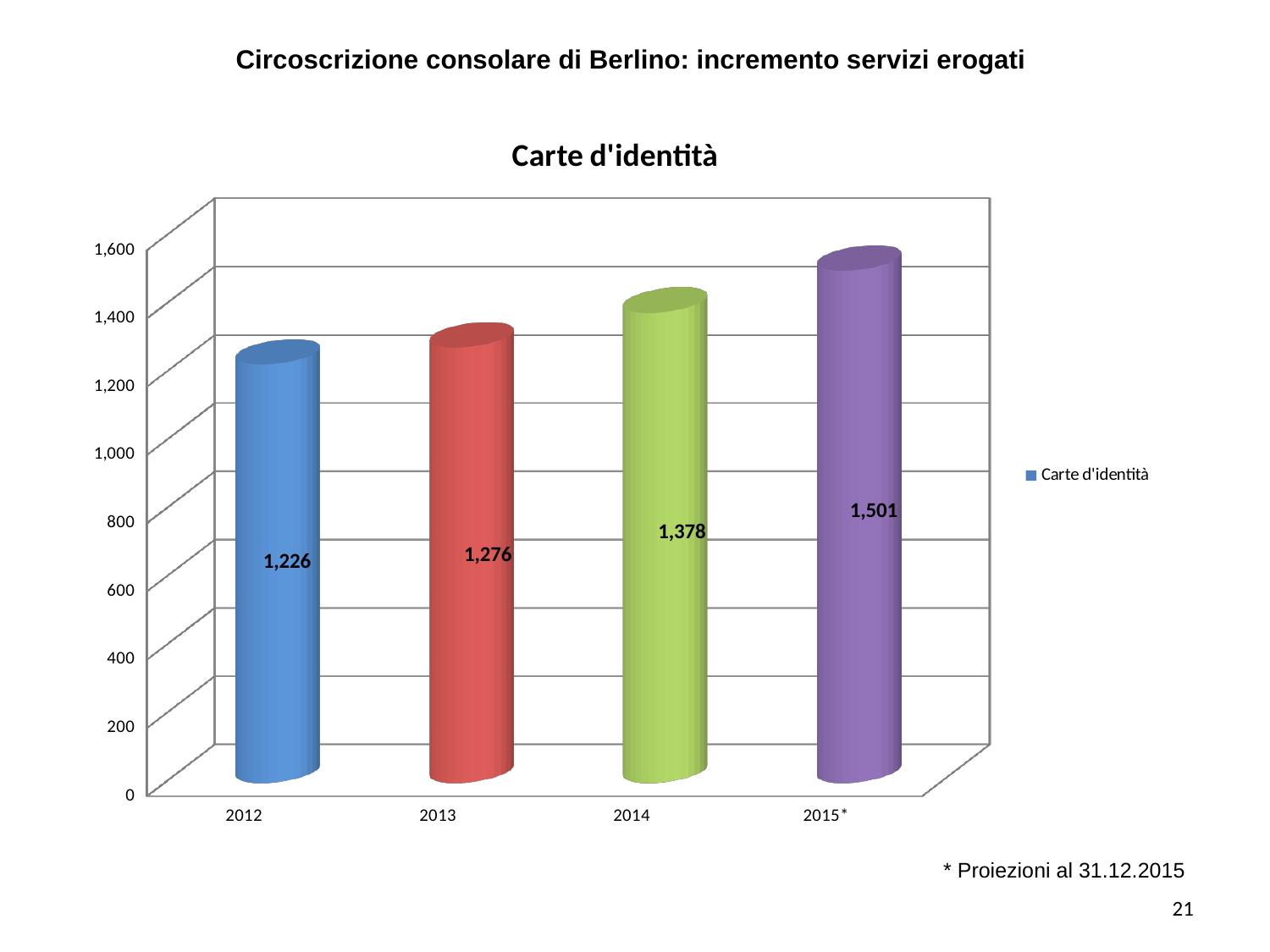
Do the values rise or fall from 2012 to 2015*? rise Which year has the lowest value? 2012 Which is larger, the value for 2013 or the value for 2014? 2014 What is the difference between the values for 2014 and 2013? 102 What is the value for 2012? 1,226 What is the value for 2014? 1,378 What kind of chart is this? bar chart What is the value for 2015*? 1,501 How many years are shown on the x axis? 4 What is the difference between the values for 2015* and 2012? 275 How many series does the legend list? 1 Which year has the highest value? 2015*